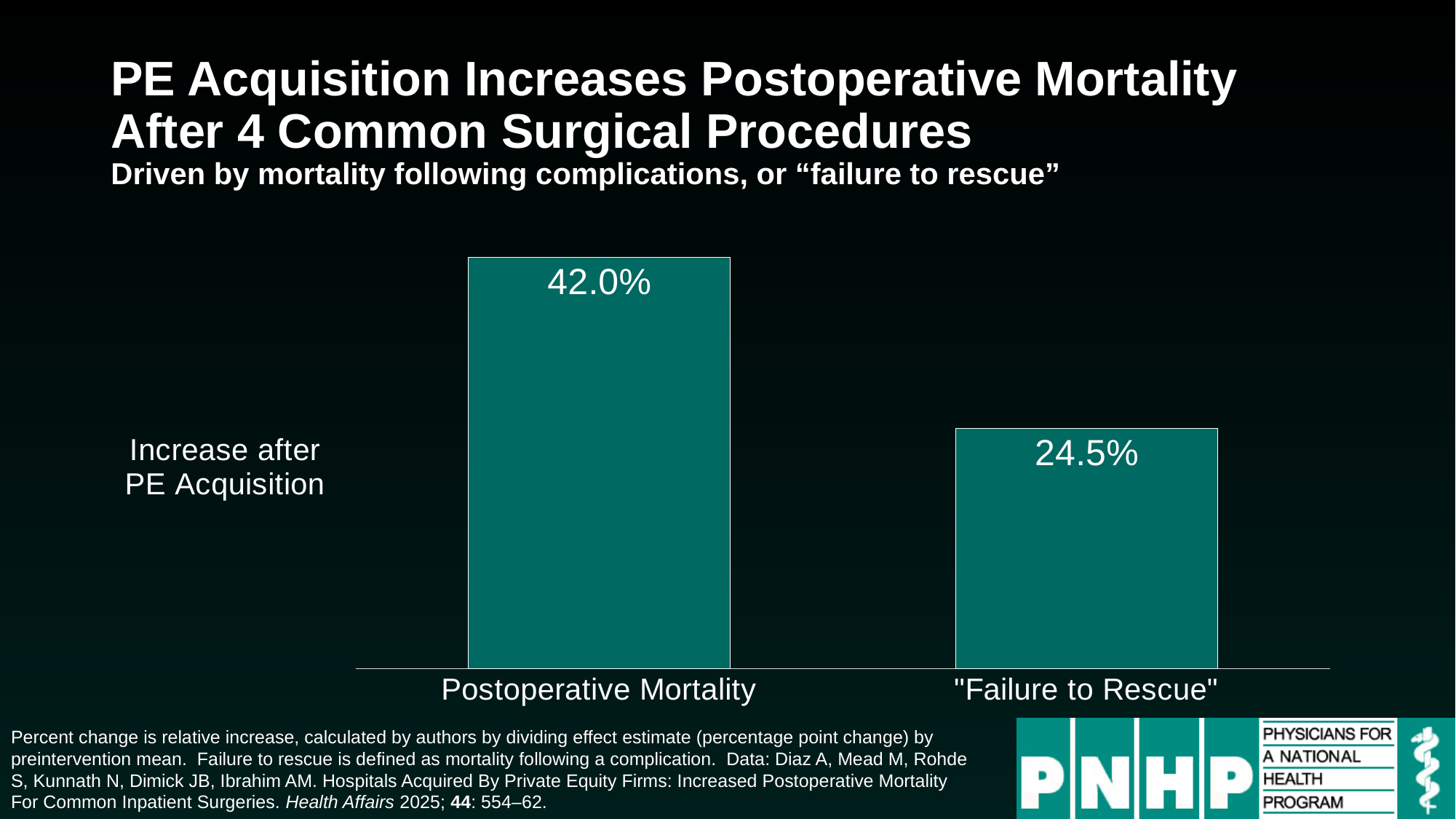
Which category shows the smaller increase after PE acquisition? "Failure to Rescue" Which category shows the larger increase after PE acquisition? Postoperative Mortality Is the increase for Postoperative Mortality larger or smaller than the increase for "Failure to Rescue"? larger What is the increase after PE acquisition for Postoperative Mortality? 42.0% What kind of chart is shown on the slide? bar chart What is the increase after PE acquisition for "Failure to Rescue"? 24.5% What is the label on the left side of the chart describing what the bars measure? Increase after PE Acquisition What is the difference between the increase for Postoperative Mortality and the increase for "Failure to Rescue"? 17.5% How many categories are plotted in the chart? 2 What colour are the bars in the chart? teal